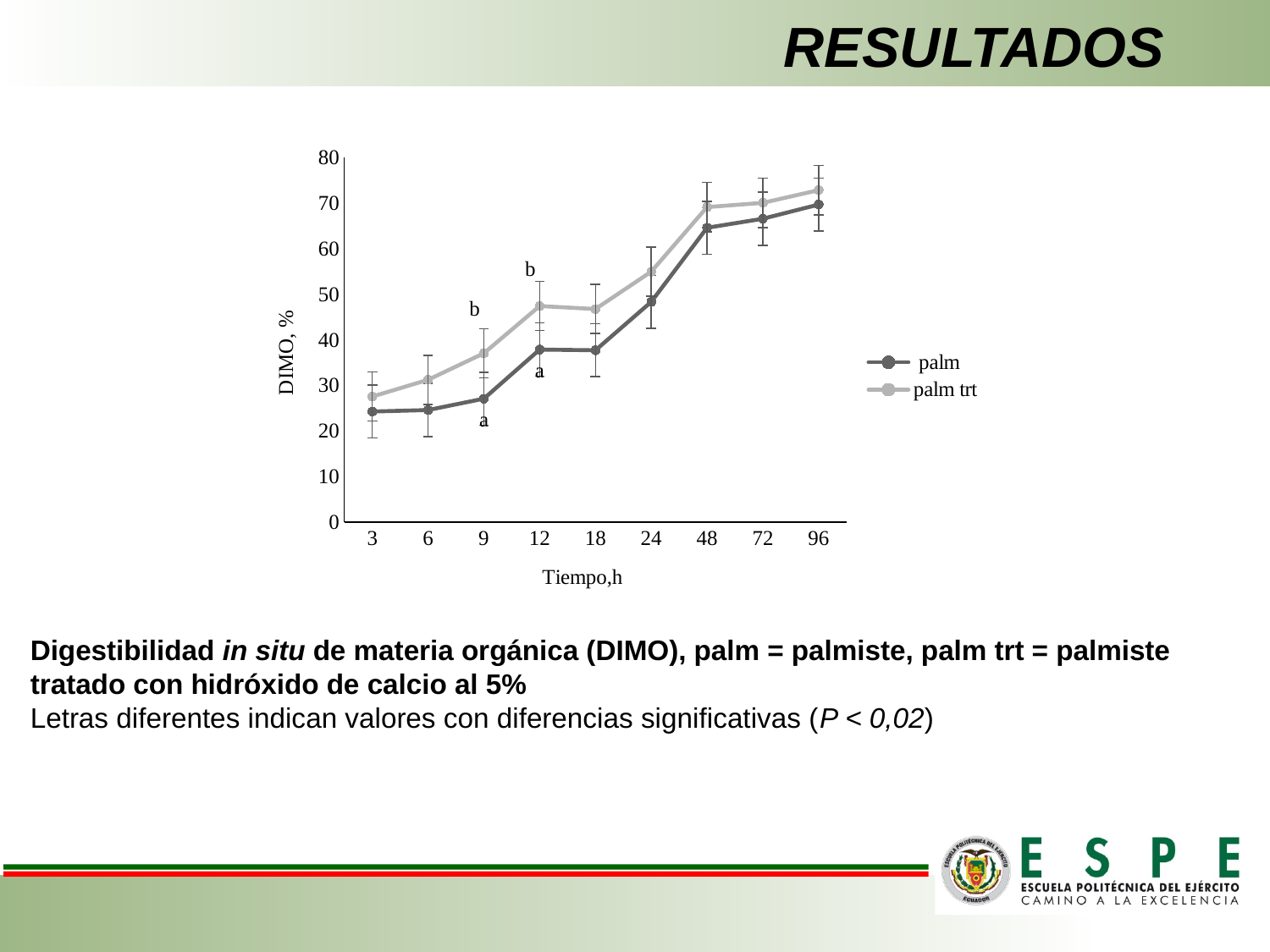
Do the DIMO values for palm generally rise or fall as time increases? rise What is the label of the x axis? Tiempo,h Is the value for palm at 3 h greater or less than 30? less At which time point does the palm trt series reach its lowest value? 3 Is the value for palm at 48 h greater or less than 60? greater What kind of chart is shown on the slide? line chart Is the value for palm trt at 24 h greater or less than 50? greater What is the label of the y axis? DIMO, % At 9 h, which series has the higher DIMO value, palm or palm trt? palm trt How many time points are plotted along the x axis? 9 How many series does the legend list? 2